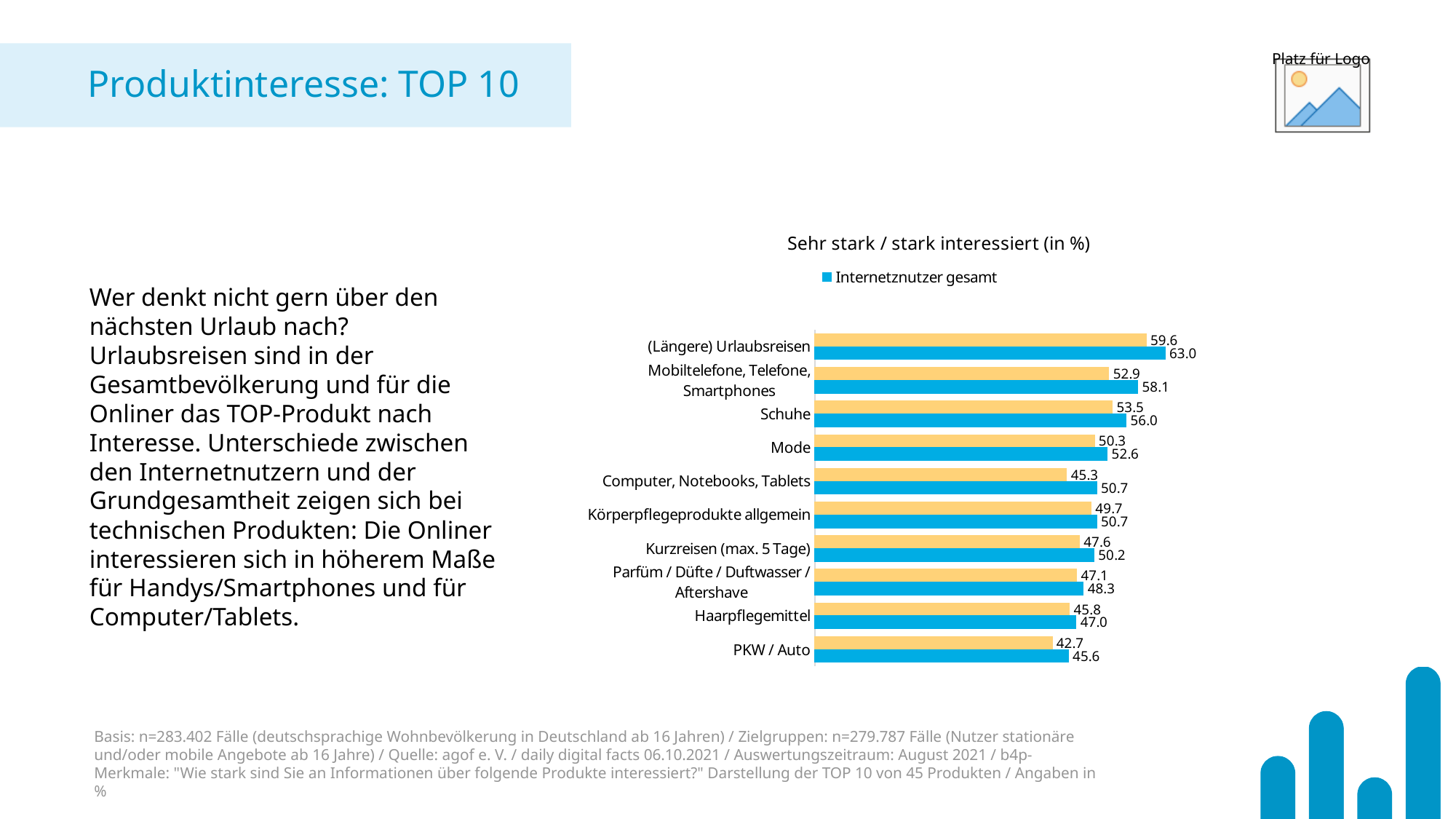
What is the value for Internetznutzer gesamt for PKW / Auto? 45.6 What is the value for Internetznutzer gesamt for Kurzreisen (max. 5 Tage)? 50.2 Which has the larger Internetznutzer gesamt value, Haarpflegemittel or Körperpflegeprodukte allgemein? Körperpflegeprodukte allgemein What type of chart is shown on the slide? Bar chart What is the difference between the Internetznutzer gesamt values for Schuhe and Mode? 3.4 Which category has the highest value for Internetznutzer gesamt? (Längere) Urlaubsreisen What value does the yellow bar show for Computer, Notebooks, Tablets? 45.3 How many product categories are shown in the chart? 10 What is the difference between the Internetznutzer gesamt value and the yellow bar value for Mobiltelefone, Telefone, Smartphones? 5.2 Which category has the lowest value for Internetznutzer gesamt? PKW / Auto What is the value for Internetznutzer gesamt for (Längere) Urlaubsreisen? 63.0 How many series does the legend list? 1